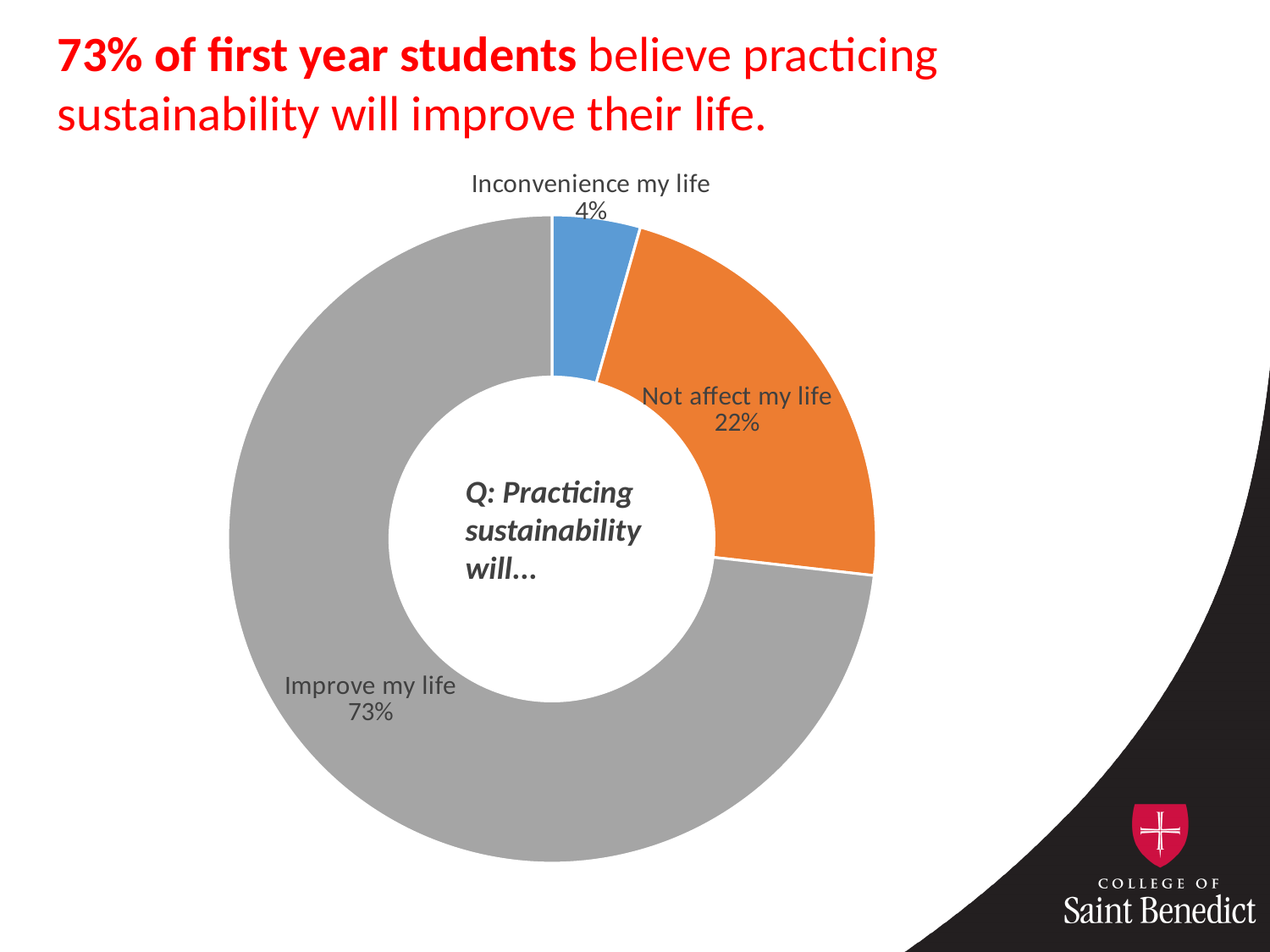
What kind of chart is shown on the slide? Doughnut (pie) chart What percentage of first year students said practicing sustainability will improve their life? 73% Which response has the largest share of the chart? Improve my life What percentage of first year students said practicing sustainability will not affect their life? 22% What is the difference in percentage points between 'Not affect my life' and 'Inconvenience my life'? 18 Which response has the smallest share of the chart? Inconvenience my life Which is larger: the share for 'Not affect my life' or 'Inconvenience my life'? Not affect my life What percentage of first year students said practicing sustainability will inconvenience their life? 4% How many response categories are shown in the chart? 3 What question is written in the centre of the chart? Q: Practicing sustainability will... What is the difference in percentage points between 'Improve my life' and 'Not affect my life'? 51 What colour is the 'Not affect my life' segment? Orange